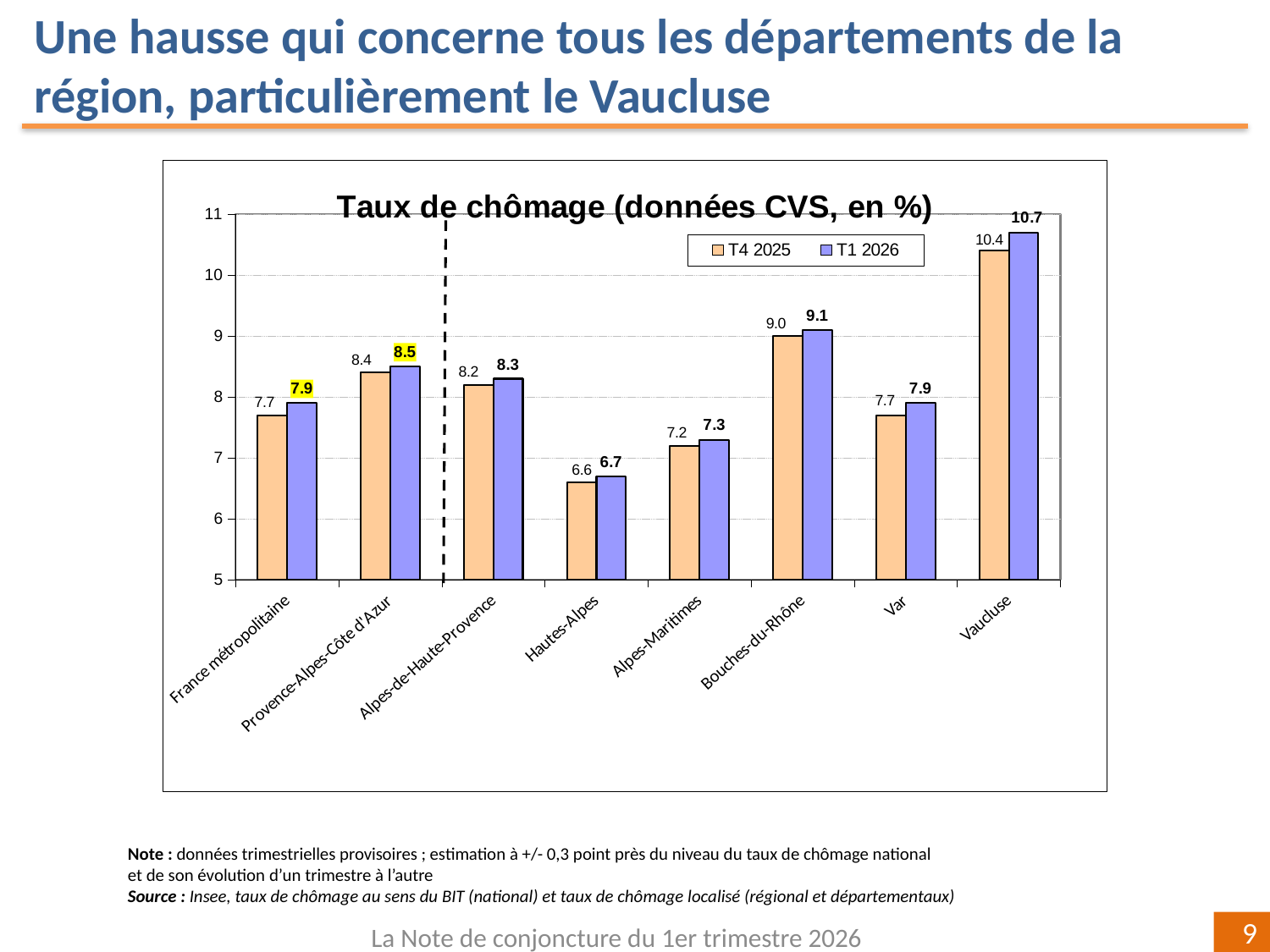
What is the T1 2026 unemployment rate for Vaucluse? 10.7 What is the T1 2026 value for Provence-Alpes-Côte d'Azur? 8.5 What is the difference between the T1 2026 and T4 2025 values for Vaucluse? 0.3 How many categories are shown on the x axis? 8 Which category has the highest T1 2026 unemployment rate? Vaucluse What kind of chart is shown on the slide? bar chart Which is larger: the T1 2026 value for Bouches-du-Rhône or the T1 2026 value for Var? Bouches-du-Rhône What is the T4 2025 unemployment rate for Hautes-Alpes? 6.6 What is the title of the chart? Taux de chômage (données CVS, en %) How many series does the legend list? 2 Which category has the lowest T4 2025 unemployment rate? Hautes-Alpes Is the T4 2025 value for Alpes-Maritimes greater or less than 8? less